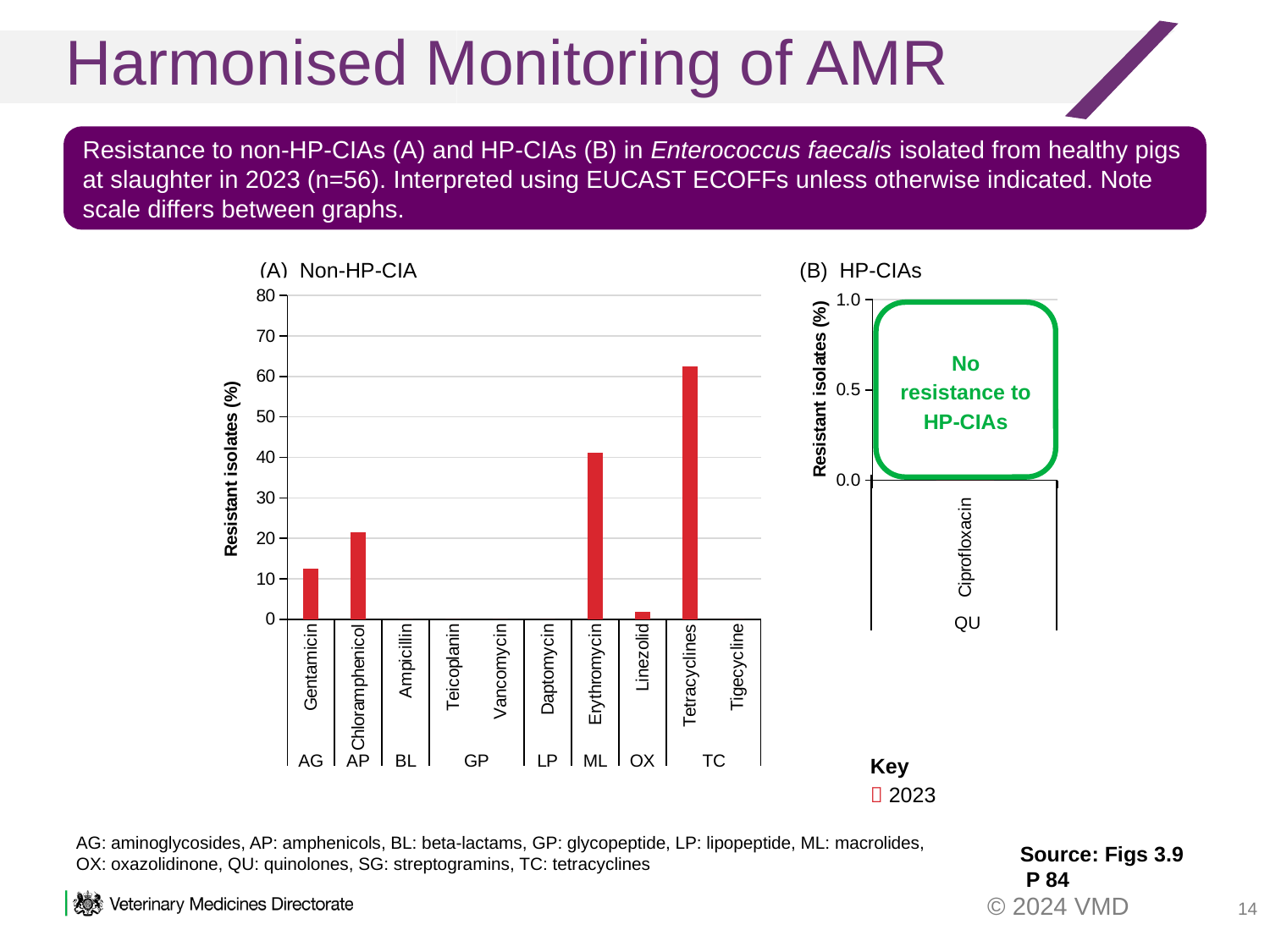
In chart (A) Non-HP-CIA, is the value for Tetracyclines greater or less than 50? greater In chart (A) Non-HP-CIA, which has a higher percentage of resistant isolates, Erythromycin or Chloramphenicol? Erythromycin In chart (A) Non-HP-CIA, is the value for Gentamicin greater or less than 10? greater What kind of chart is chart (A) Non-HP-CIA? Bar chart What is the y-axis label of chart (A) Non-HP-CIA? Resistant isolates (%) In chart (A) Non-HP-CIA, which has a higher percentage of resistant isolates, Gentamicin or Linezolid? Gentamicin In chart (A) Non-HP-CIA, is the value for Linezolid greater or less than 10? less What does the annotation in chart (B) HP-CIAs say? No resistance to HP-CIAs In chart (A) Non-HP-CIA, which antimicrobial has the highest percentage of resistant isolates? Tetracyclines How many antimicrobials are shown on the x axis of chart (A) Non-HP-CIA? 10